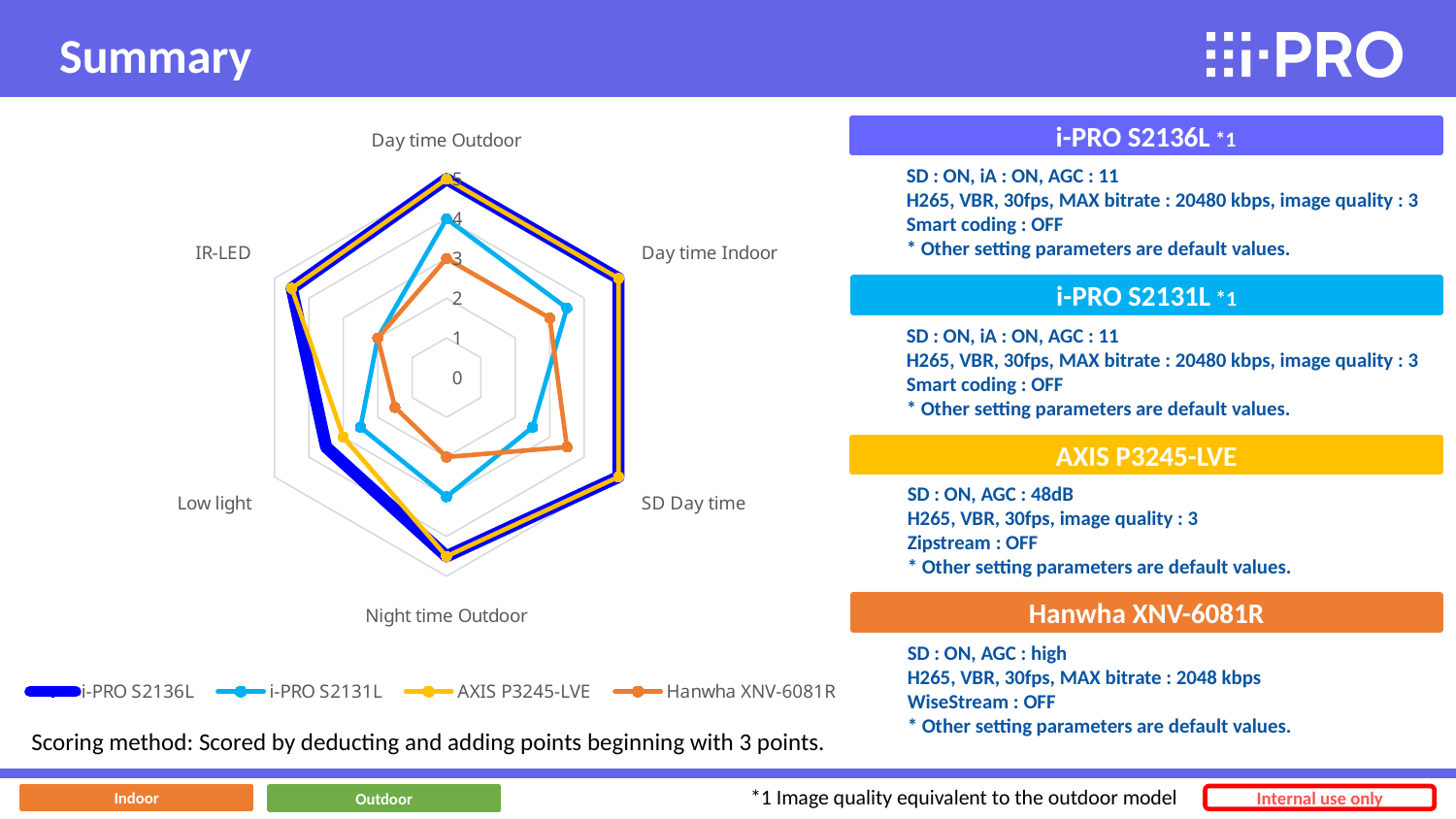
Which series has the lowest score for Night time Outdoor? Hanwha XNV-6081R What is the score of i-PRO S2136L for Day time Outdoor? 5 How many series does the chart legend list? 4 What is the score of Hanwha XNV-6081R for Day time Outdoor? 3 Is the score of i-PRO S2131L for Low light greater or less than 3? less What is the score of i-PRO S2131L for Day time Outdoor? 4 What kind of chart is shown on the slide? Radar chart What colour is used for the Hanwha XNV-6081R series in the chart? Orange How many categories (axes) does the radar chart have? 6 Which series has the lowest score for Day time Outdoor? Hanwha XNV-6081R Which is larger for Night time Outdoor: the score of i-PRO S2136L or Hanwha XNV-6081R? i-PRO S2136L